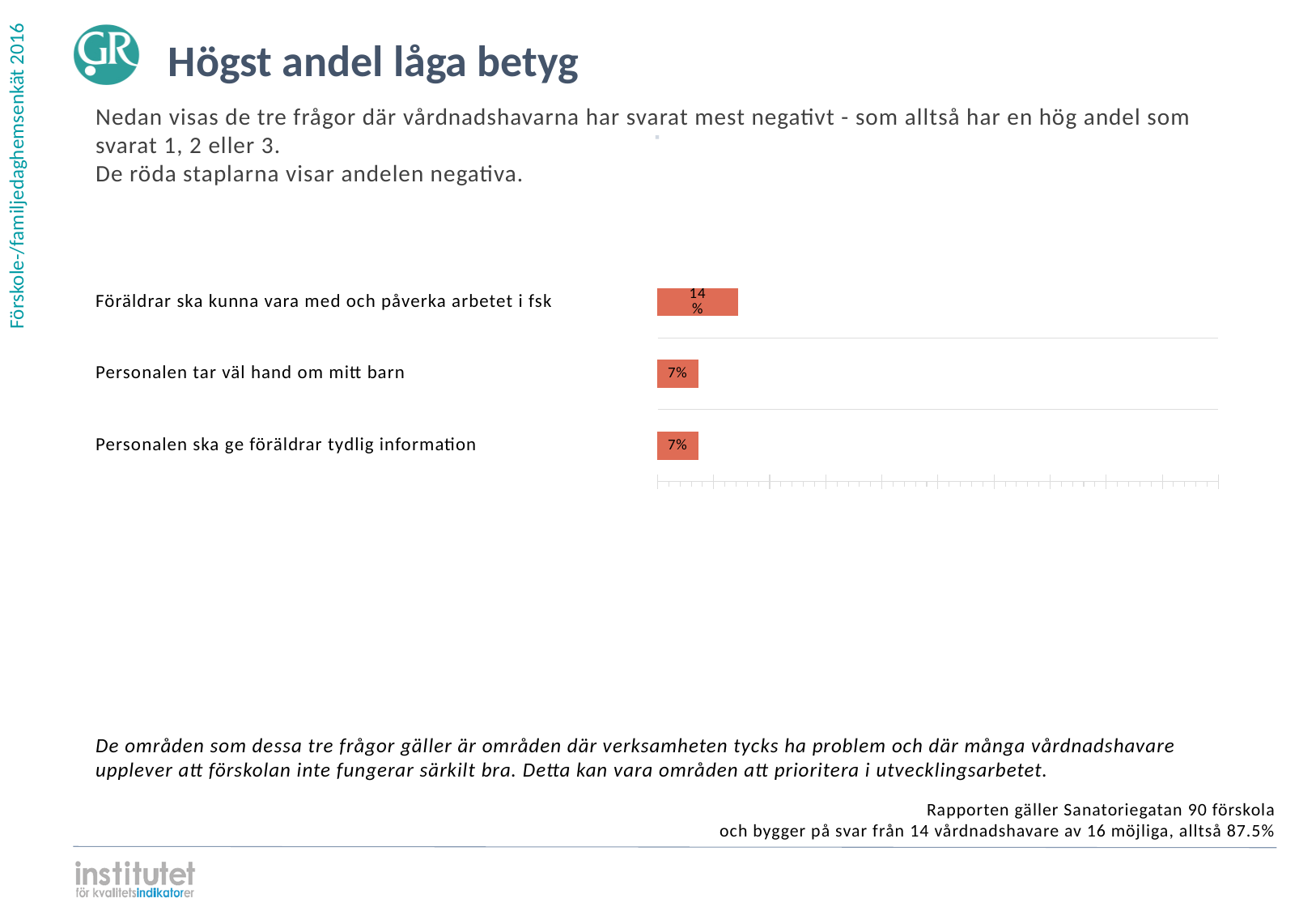
What is the title of the slide containing the chart? Högst andel låga betyg What is the difference between the value for "Föräldrar ska kunna vara med och påverka arbetet i fsk" and the value for "Personalen tar väl hand om mitt barn"? 7% Which category has the highest share of negative answers? Föräldrar ska kunna vara med och påverka arbetet i fsk What is the value for "Personalen tar väl hand om mitt barn"? 7% Do the two categories "Personalen tar väl hand om mitt barn" and "Personalen ska ge föräldrar tydlig information" have the same value? Yes Which is larger: the value for "Föräldrar ska kunna vara med och påverka arbetet i fsk" or the value for "Personalen ska ge föräldrar tydlig information"? Föräldrar ska kunna vara med och påverka arbetet i fsk What is the value for "Föräldrar ska kunna vara med och påverka arbetet i fsk"? 14% What kind of chart is shown on the slide? Bar chart What colour are the bars in the chart? Red How many categories are shown in the chart? 3 What is the value for "Personalen ska ge föräldrar tydlig information"? 7%